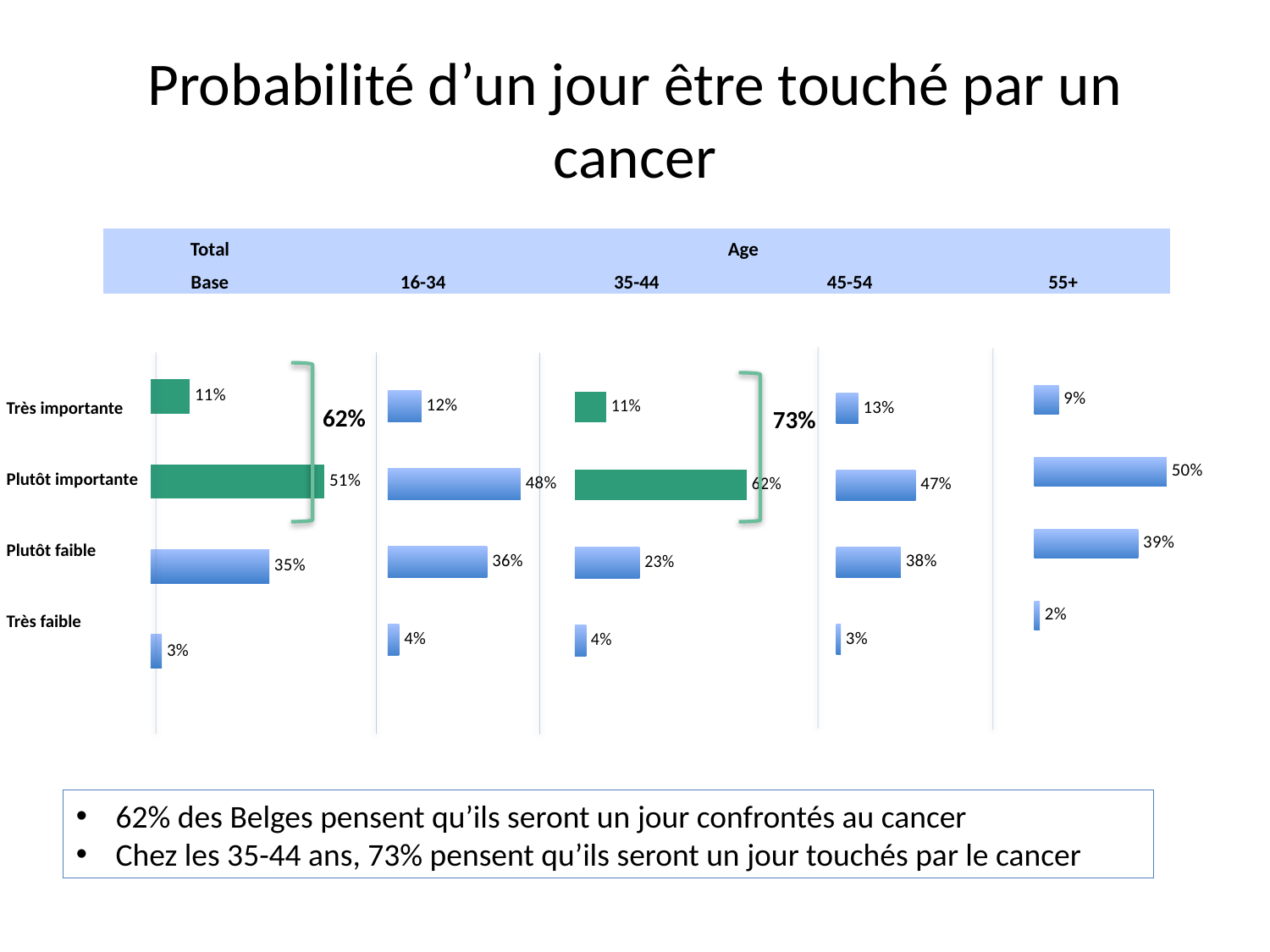
In the Total Base chart, what is the value for Plutôt importante? 51% In the 45-54 chart, which category has the highest value? Plutôt importante In the 35-44 chart, what is the difference between Plutôt importante and Plutôt faible? 39% In the 55+ chart, what is the value for Très faible? 2% In the 35-44 chart, what is the value for Plutôt importante? 62% How many categories are shown in the 16-34 chart? 4 In the 16-34 chart, which category has the lowest value? Très faible What kind of chart is used for the Total Base data? Bar chart Which is larger: Plutôt faible in the 55+ chart or Plutôt faible in the 45-54 chart? 55+ In the 16-34 chart, what is the value for Très importante? 12% How many age groups are shown in the charts under the Age heading? 4 In the Total Base chart, what is the total of Très importante and Plutôt importante? 62%